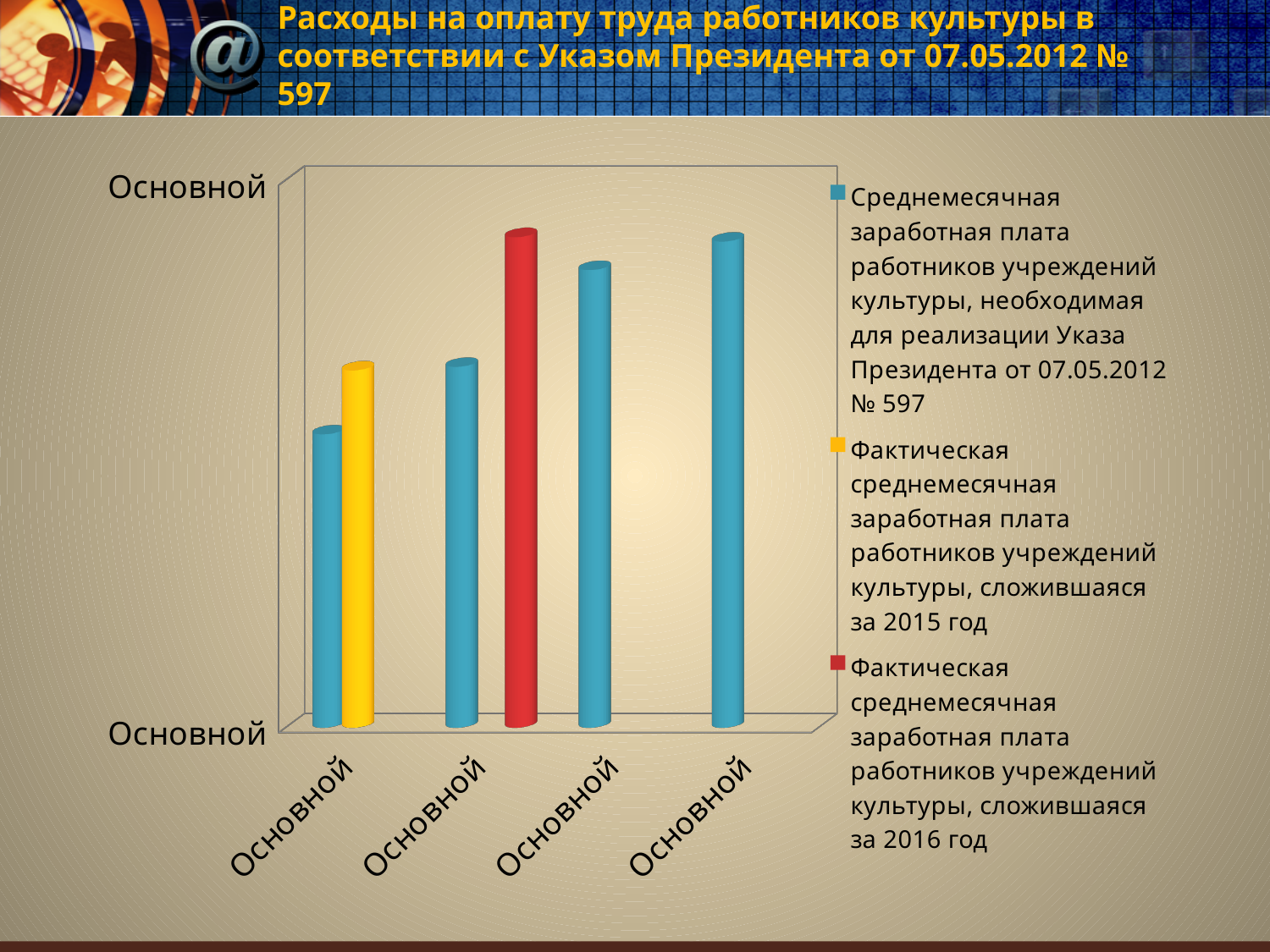
What kind of chart is shown on the slide? bar chart Which colour represents the series 'Фактическая среднемесячная заработная плата работников учреждений культуры, сложившаяся за 2016 год'? red Which category group contains the shortest bar on the chart? the first group Do the blue bars (the first legend series) rise or fall from left to right across the category groups? rise What is the title of the slide containing the chart? Расходы на оплату труда работников культуры в соответствии с Указом Президента от 07.05.2012 № 597 Which bar on the chart is the shortest? the blue bar in the first category group How many category groups are shown along the x axis? 4 How many series does the legend list? 3 In the first category group, which bar is taller: the blue bar or the yellow bar? the yellow bar